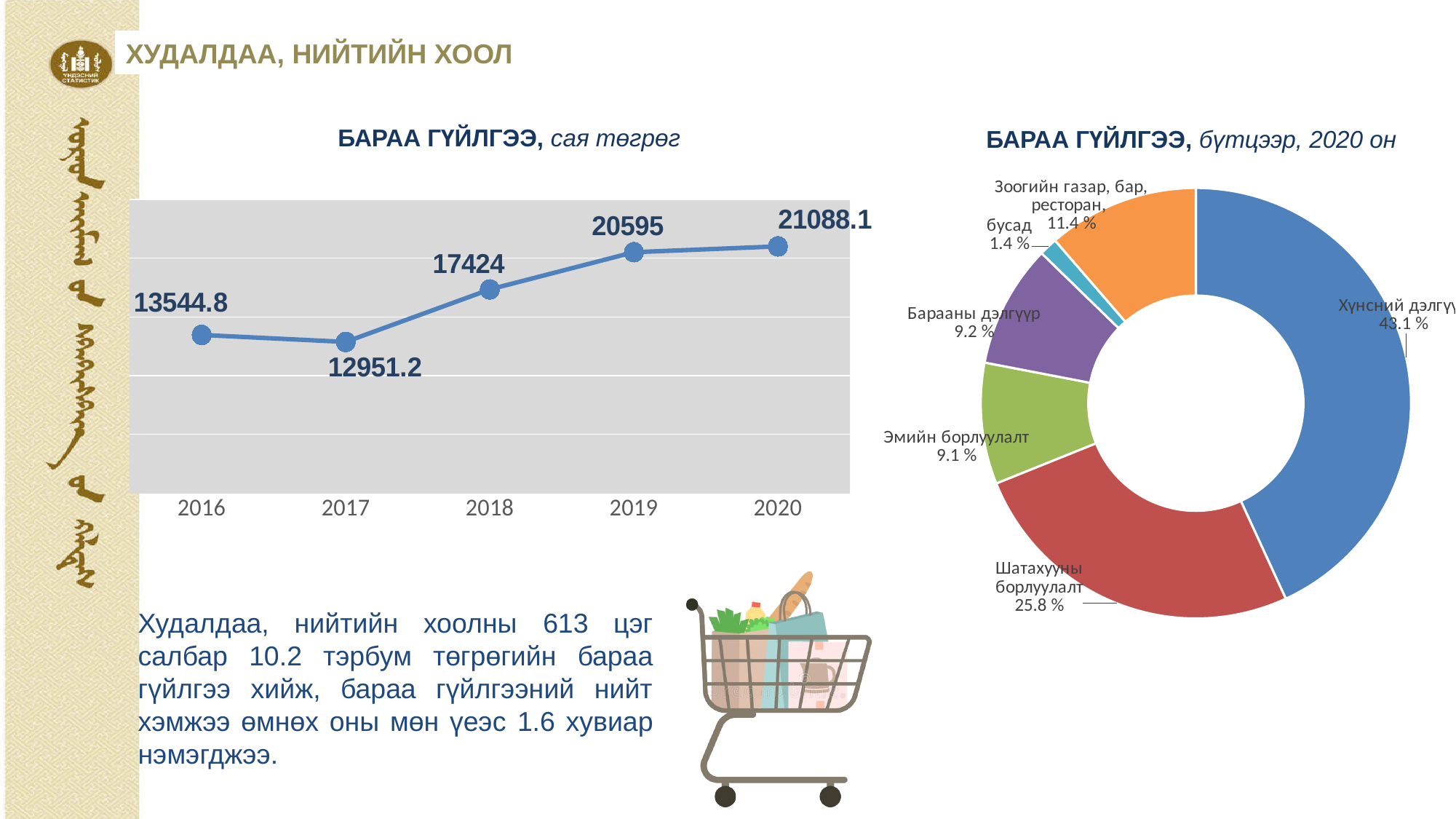
In the doughnut chart titled 'БАРАА ГҮЙЛГЭЭ, бүтцээр, 2020 он', how many slices are there? 6 In the doughnut chart titled 'БАРАА ГҮЙЛГЭЭ, бүтцээр, 2020 он', what share does 'Шатахууны борлуулалт' have? 25.8 % In the line chart titled 'БАРАА ГҮЙЛГЭЭ, сая төгрөг', do the values generally rise or fall from 2017 to 2020? rise In the doughnut chart titled 'БАРАА ГҮЙЛГЭЭ, бүтцээр, 2020 он', which category has the smallest share? бусад In the doughnut chart titled 'БАРАА ГҮЙЛГЭЭ, бүтцээр, 2020 он', what share does 'Зоогийн газар, бар, ресторан' have? 11.4 % In the line chart titled 'БАРАА ГҮЙЛГЭЭ, сая төгрөг', what is the value for 2020? 21088.1 In the line chart titled 'БАРАА ГҮЙЛГЭЭ, сая төгрөг', what is the value for 2018? 17424 In the line chart titled 'БАРАА ГҮЙЛГЭЭ, сая төгрөг', what is the difference between the 2019 and 2018 values? 3171 In the line chart titled 'БАРАА ГҮЙЛГЭЭ, сая төгрөг', how many years are plotted? 5 What kind of chart is the chart titled 'БАРАА ГҮЙЛГЭЭ, сая төгрөг'? line chart In the line chart titled 'БАРАА ГҮЙЛГЭЭ, сая төгрөг', which year has the lowest value? 2017 In the line chart titled 'БАРАА ГҮЙЛГЭЭ, сая төгрөг', which year has the highest value? 2020